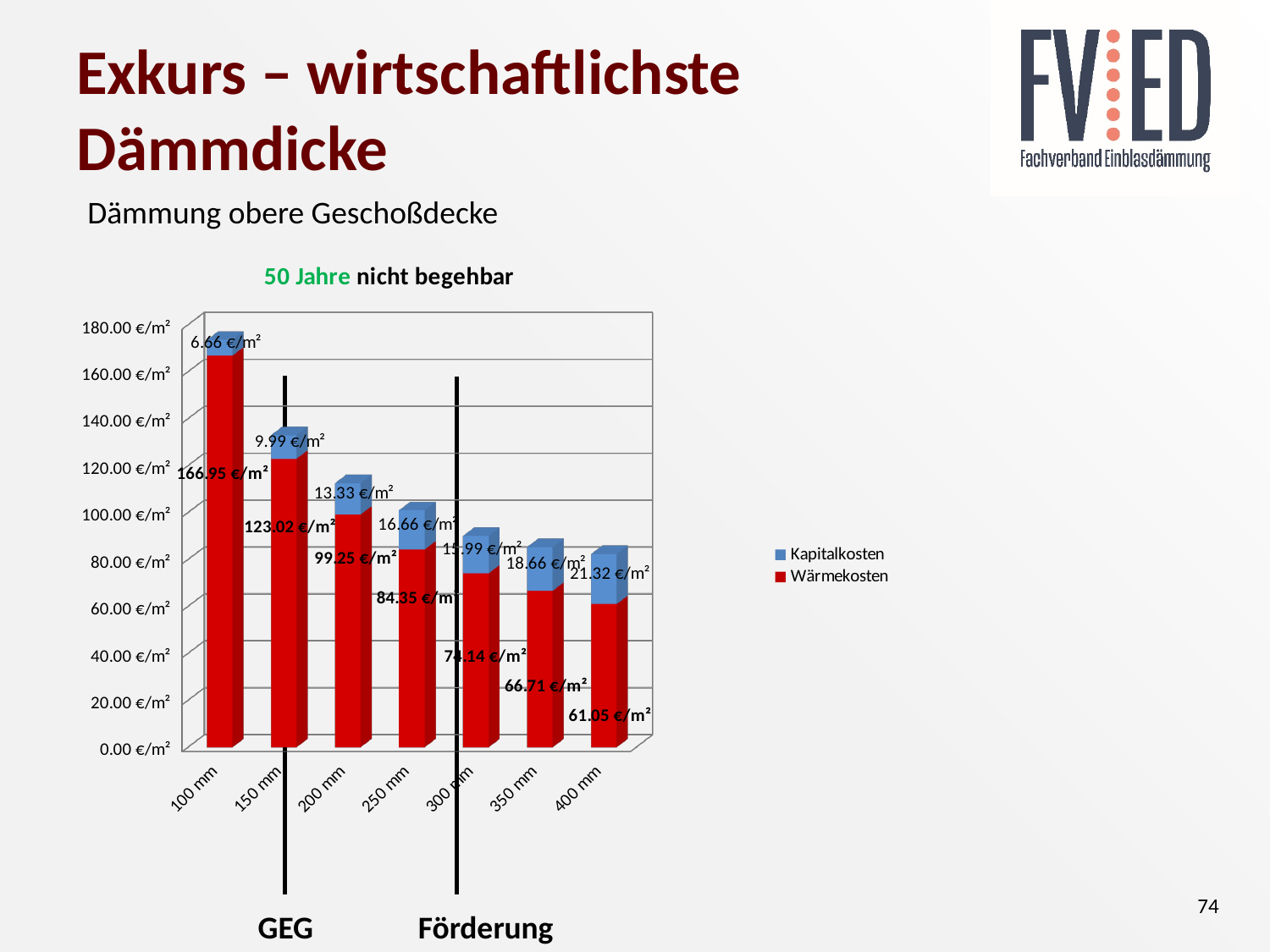
What kind of chart is shown? Stacked bar chart What is the Wärmekosten value for 250 mm? 84.35 €/m² What is the total of the stacked bar for 100 mm (Wärmekosten plus Kapitalkosten)? 173.61 €/m² How many series does the legend list? 2 Which insulation thickness has the lowest Wärmekosten? 400 mm Which is larger, the Kapitalkosten for 200 mm or for 350 mm? 350 mm What is the difference between the Wärmekosten for 150 mm and 200 mm? 23.77 €/m² Is the total height of the 400 mm bar greater or less than 100.00 €/m²? less What is the Wärmekosten value for 100 mm? 166.95 €/m² What is the Kapitalkosten value for 400 mm? 21.32 €/m² Which insulation thickness has the highest Wärmekosten? 100 mm How many insulation thickness categories are shown on the x axis? 7